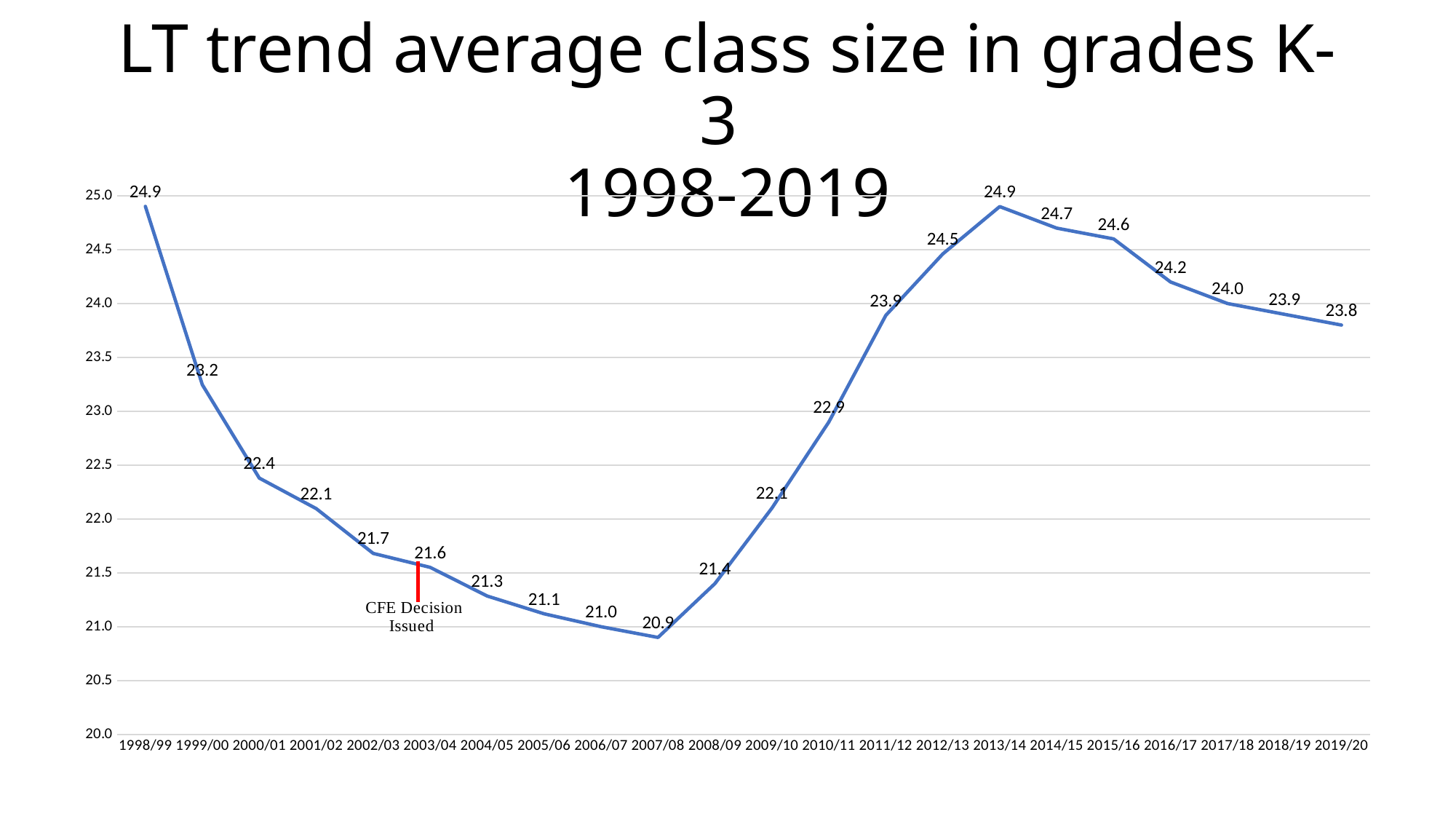
How many school years are plotted on the x axis? 22 Does the average class size rise or fall from 2013/14 to 2019/20? fall What is the difference between the average class size in 2013/14 and in 2019/20? 1.1 What event is annotated with a red marker on the chart? CFE Decision Issued What type of chart is shown on the slide? line chart What is the average class size for 2019/20? 23.8 What is the difference between the average class size in 1998/99 and in 2007/08? 4.0 Which school year has the lowest average class size? 2007/08 What is the average class size for 2013/14? 24.9 Which is larger, the average class size in 2010/11 or in 2000/01? 2010/11 What is the average class size for 2003/04, the year marked 'CFE Decision Issued'? 21.6 What is the average class size for 2007/08? 20.9